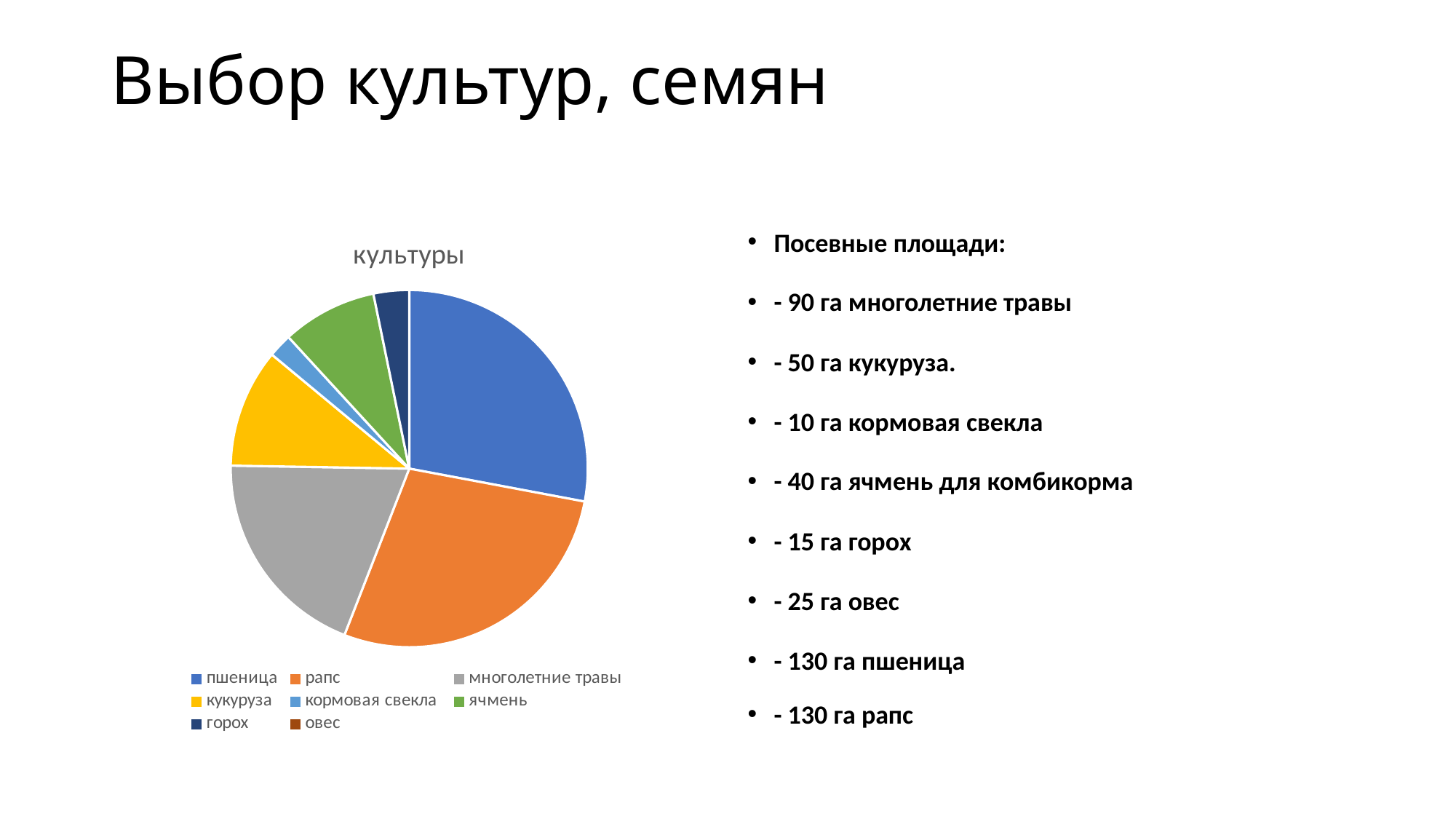
What kind of chart is shown on the slide? pie chart Which is larger in the pie chart, the slice for рапс or the slice for кукуруза? рапс What is the title of the chart? культуры Which is larger in the pie chart, the slice for многолетние травы or the slice for кукуруза? многолетние травы What colour is the slice for пшеница in the pie chart? blue Which is larger in the pie chart, the slice for ячмень or the slice for горох? ячмень How many categories does the chart legend list? 8